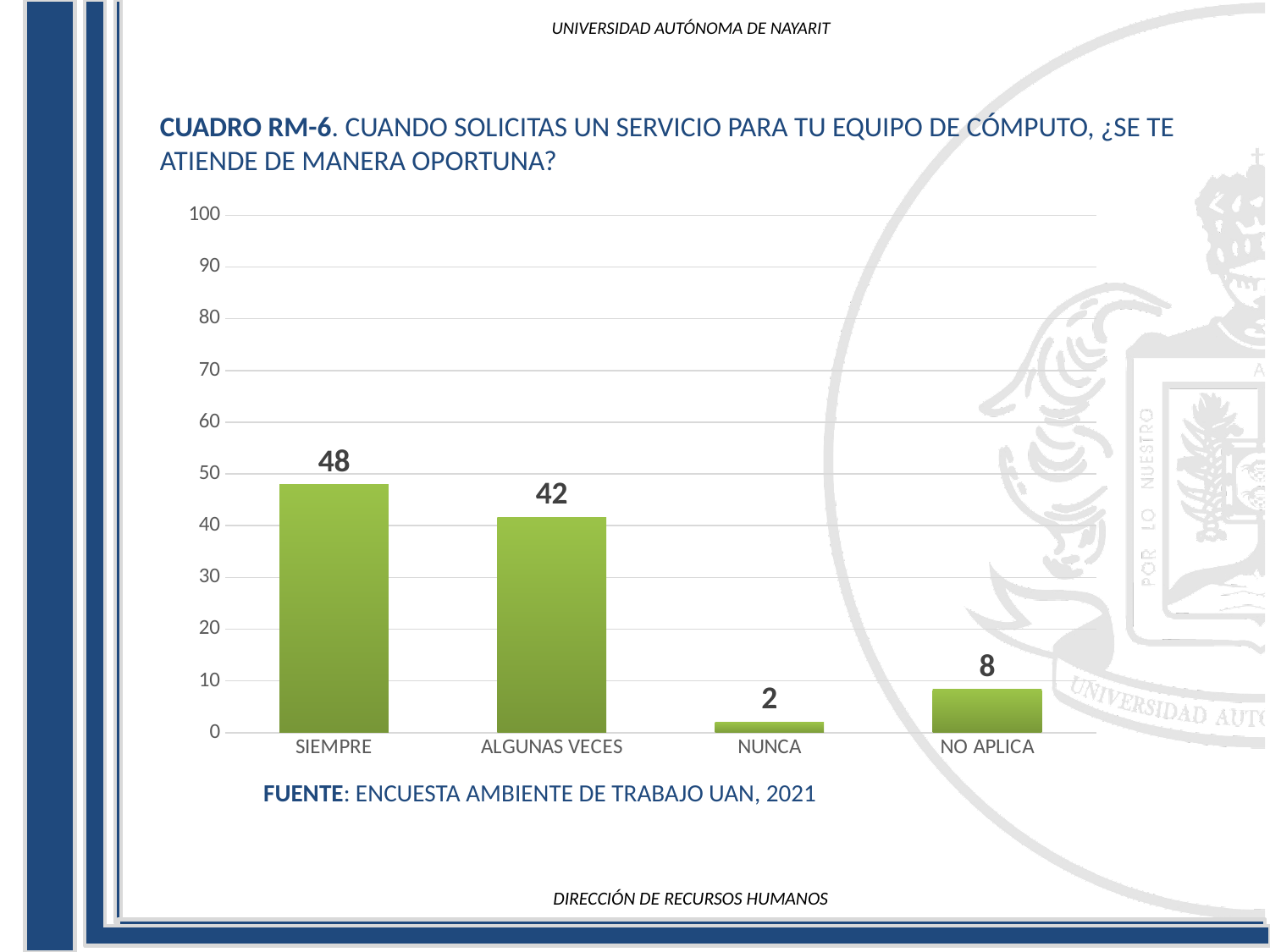
How many categories are shown on the x axis? 4 What source is cited below the chart? ENCUESTA AMBIENTE DE TRABAJO UAN, 2021 What kind of chart is shown on the slide? bar chart What is the value for SIEMPRE? 48 What is the difference between the values for SIEMPRE and ALGUNAS VECES? 6 Which category has the highest value? SIEMPRE Is the value for ALGUNAS VECES greater or less than 50? less What is the value for ALGUNAS VECES? 42 Which category has the lowest value? NUNCA What is the value for NO APLICA? 8 Which is larger, the value for NO APLICA or the value for NUNCA? NO APLICA What is the value for NUNCA? 2